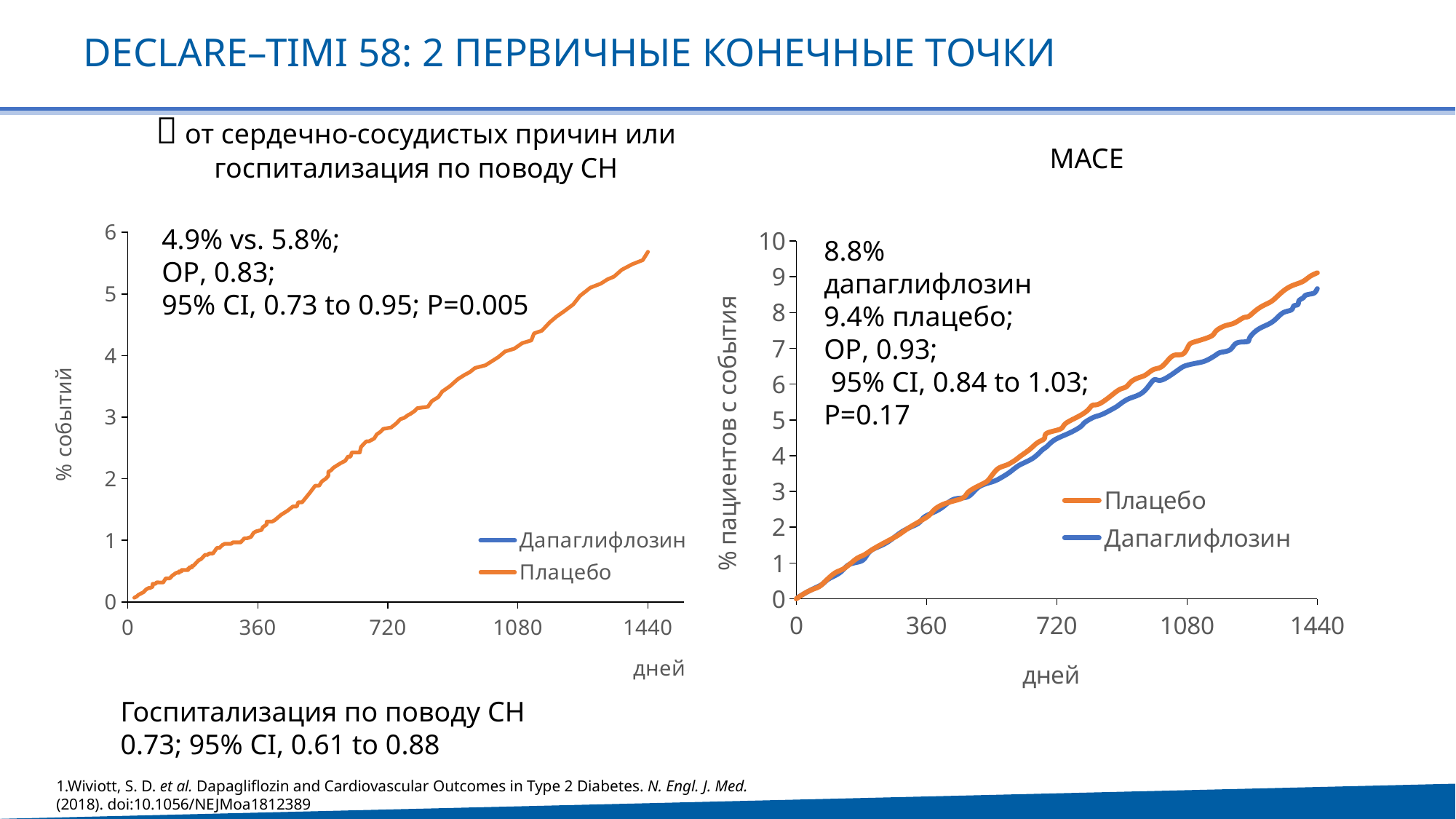
What kind of chart is the right chart (MACE)? line chart How many series does the legend of the MACE chart list? 2 In the left chart, is the value of the Плацебо line at 720 days greater or less than 2? greater How many series does the legend of the left chart list? 2 In the MACE chart, which line is higher at 1440 days, Плацебо or Дапаглифлозин? Плацебо What is the y-axis label of the MACE chart? % пациентов с события What unit is shown on the x axis of both charts? дней In the left chart, is the value of the Плацебо line at 1440 days greater or less than 5? greater In the MACE chart, does the Плацебо line rise or fall as days increase? rise What kind of chart is the left chart (от сердечно-сосудистых причин или госпитализация по поводу СН)? line chart In the MACE chart, is the value of the Плацебо line at 1440 days greater or less than 8? greater